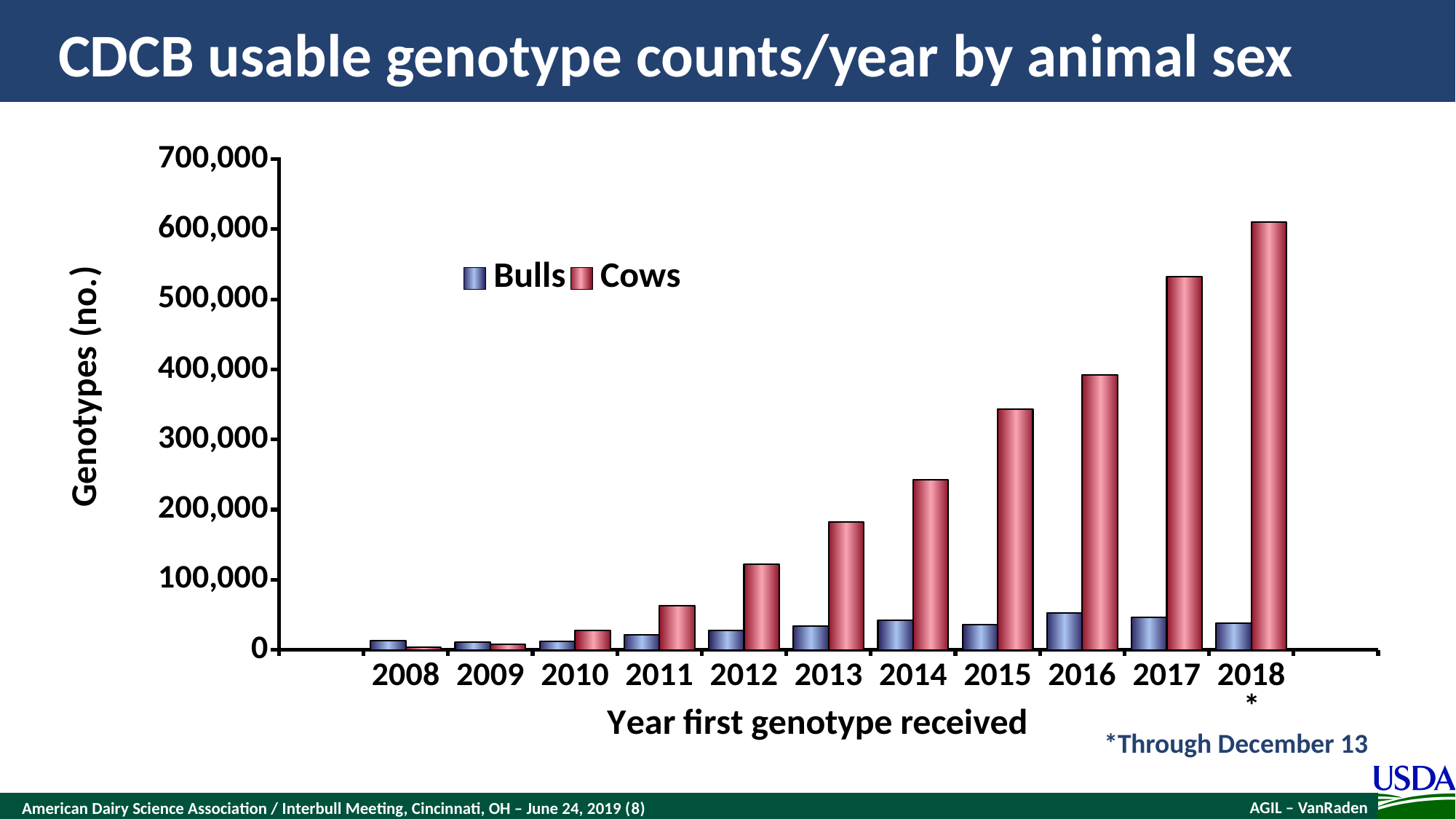
Is the Cows value for 2017 greater or less than 500,000? greater How many series does the legend list? 2 What is the title of the x axis? Year first genotype received Is the Bulls value for 2016 greater or less than 100,000? less Is the Cows value for 2014 greater or less than 200,000? greater Which year has the highest Cows value? 2018 Which year has the lowest Cows value? 2008 In 2018, which is larger, the Bulls value or the Cows value? Cows What kind of chart is shown on the slide? Bar chart Do the Cows values generally rise or fall from 2008 to 2018? rise How many years are shown on the x axis? 11